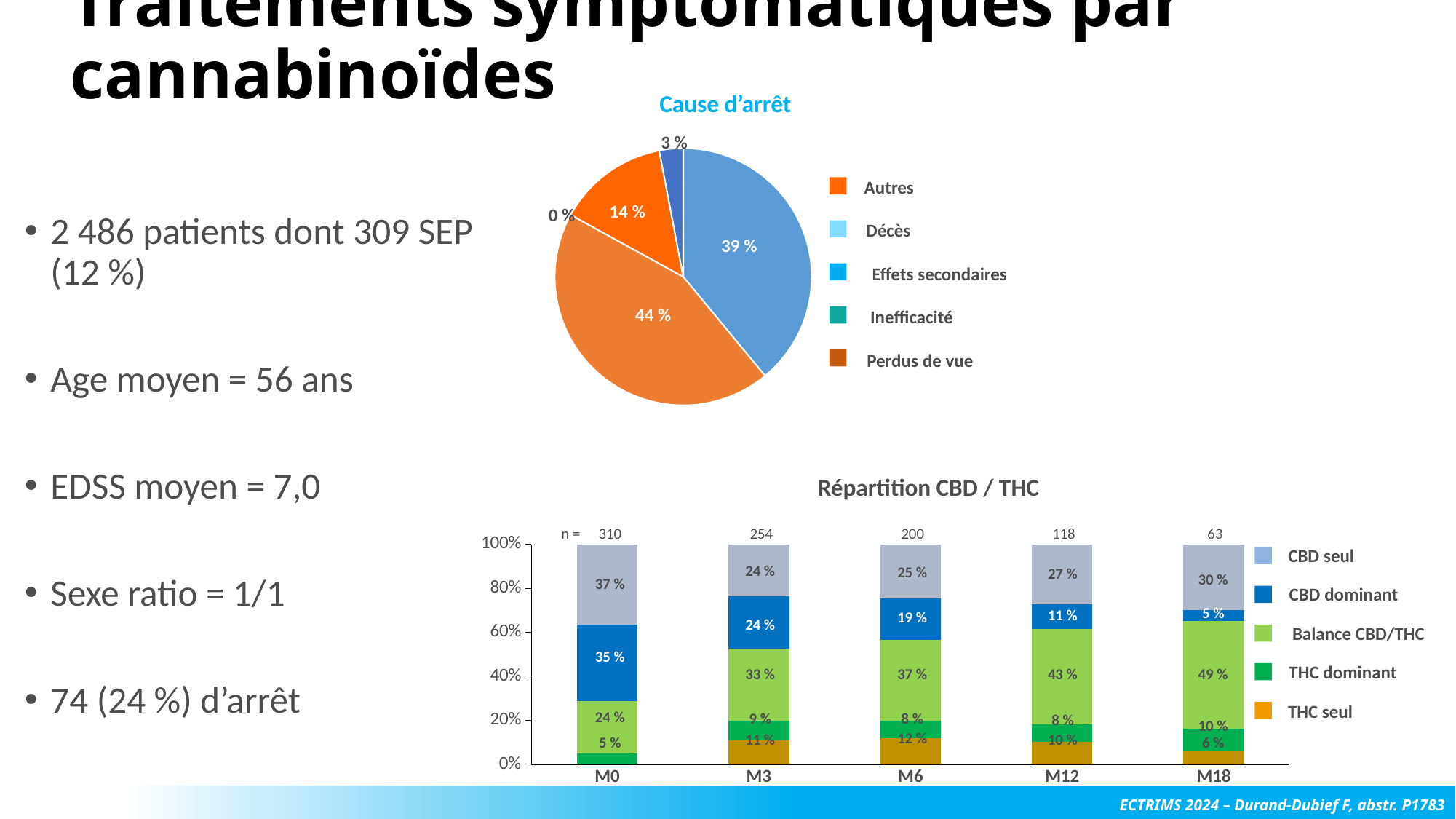
In the 'Répartition CBD / THC' chart, what is the value for CBD seul at M0? 37 % In the 'Répartition CBD / THC' chart, does the Balance CBD/THC share rise or fall from M0 to M18? Rise In the 'Cause d'arrêt' pie chart, what is the percentage of the largest slice? 44 % In the 'Répartition CBD / THC' chart, what is the n value shown above the M12 bar? 118 In the 'Répartition CBD / THC' chart, does the CBD dominant share rise or fall from M0 to M18? Fall In the 'Répartition CBD / THC' chart, what is the value for CBD dominant at M6? 19 % What kind of chart is the 'Répartition CBD / THC' chart? Stacked bar chart What kind of chart is the 'Cause d'arrêt' chart? Pie chart In the 'Répartition CBD / THC' chart, what is the difference between the CBD dominant value at M0 and at M18? 30 % In the 'Répartition CBD / THC' chart, what is the value for Balance CBD/THC at M18? 49 % How many entries does the legend of the 'Cause d'arrêt' pie chart list? 5 How many time points (bars) are shown on the x axis of the 'Répartition CBD / THC' chart? 5